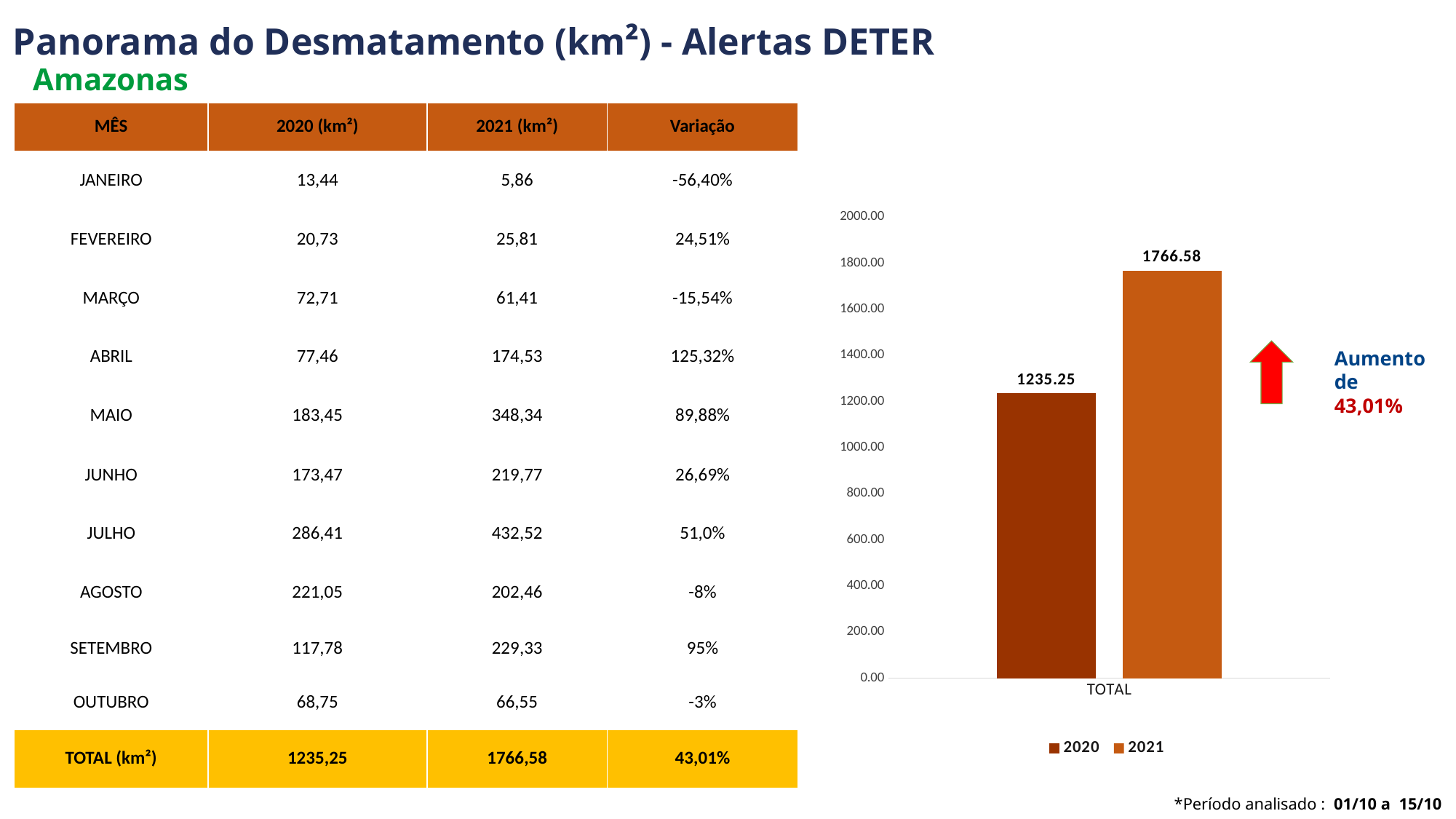
In the bar chart, which series has the lowest value? 2020 What type of chart is shown on the slide? bar chart How many categories are shown on the x axis of the bar chart? 1 In the bar chart, what is the value of the 2021 bar for TOTAL? 1766.58 In the bar chart, is the value for 2021 greater or less than 1600? greater In the bar chart, what is the value of the 2020 bar for TOTAL? 1235.25 In the bar chart, what is the difference between the 2021 and 2020 values for TOTAL? 531.33 What is the highest value shown on the y axis of the bar chart? 2000.00 In the bar chart, which series has the higher value for TOTAL, 2020 or 2021? 2021 In the bar chart, is the value for 2020 greater or less than 1400? less How many series does the legend of the bar chart list? 2 What is the category label on the x axis of the bar chart? TOTAL